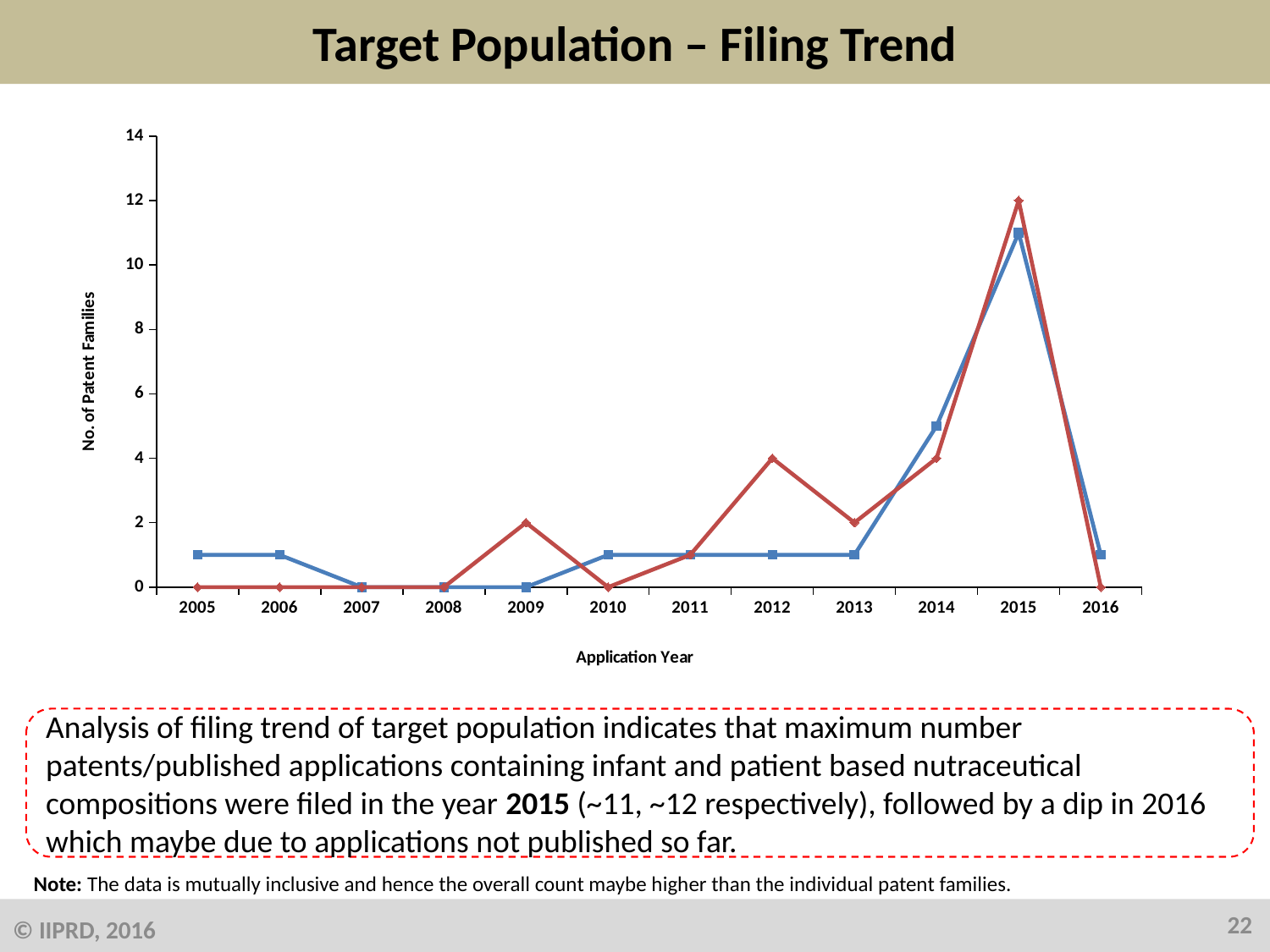
In 2012, which line has the larger value, the red line or the blue line? red line Is the value of the blue line in 2014 greater or less than 4? greater What is the value of the red line in 2009? 2 In which year does the red line reach its highest value? 2015 What is the value of the red line in 2012? 4 Is the value of the blue line in 2015 greater or less than 10? greater What kind of chart is shown on the slide? line chart What is the title of the x axis? Application Year What is the value of the red line in 2015? 12 How many application years are plotted on the x axis? 12 What is the difference between the red line's value in 2015 and its value in 2013? 10 What is the value of the blue line in 2008? 0